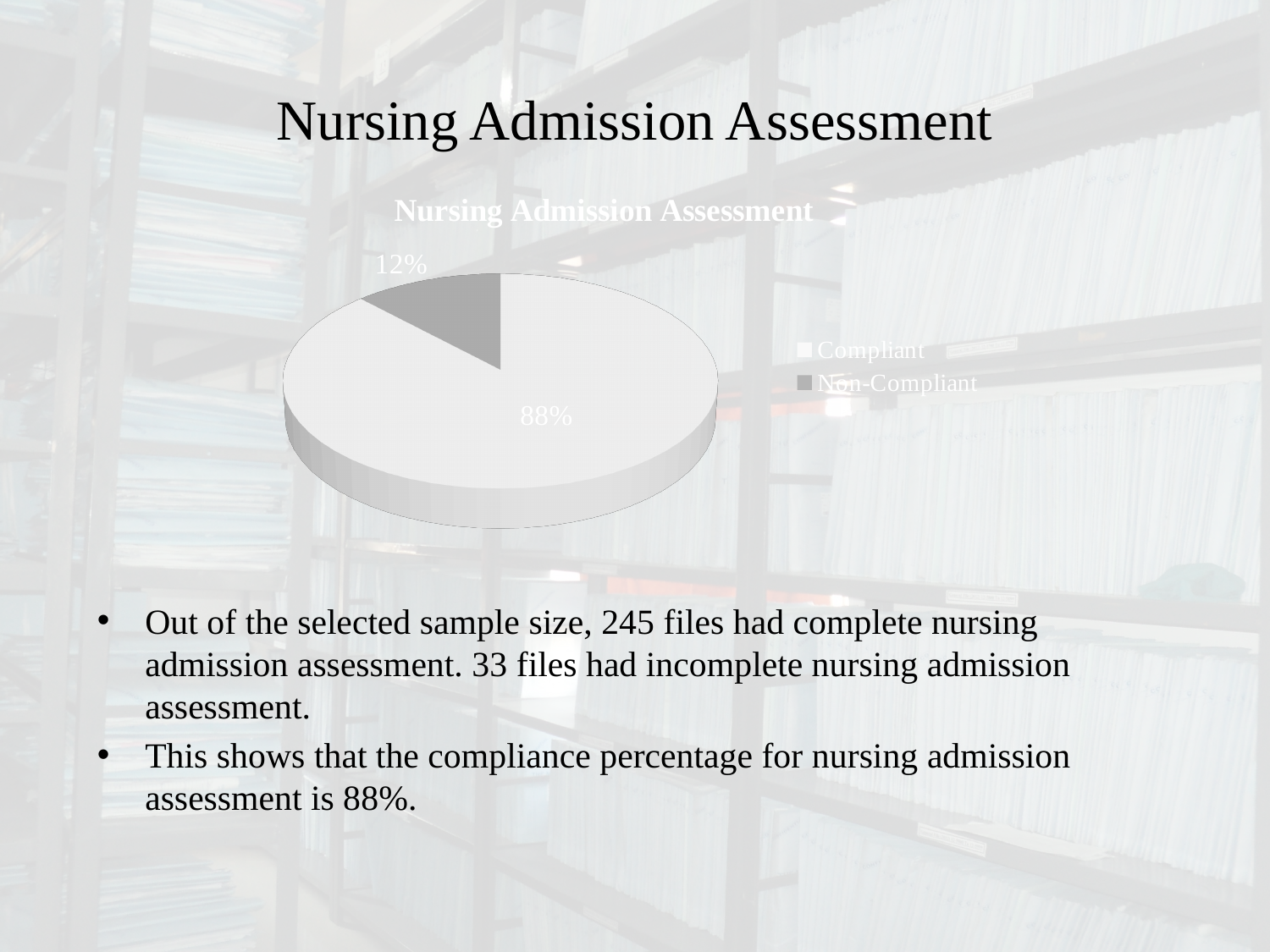
How many slices does the pie chart have? 2 Which slice of the pie is the largest? Compliant What percentage of the pie is labelled Non-Compliant? 12% What is the difference in percentage points between the Compliant and Non-Compliant slices? 76 Which is larger, the Compliant slice or the Non-Compliant slice? Compliant Which slice of the pie is the smallest? Non-Compliant What percentage of the pie is labelled Compliant? 88% What kind of chart is shown on the slide? Pie chart What is the title of the chart? Nursing Admission Assessment How many entries does the legend list? 2 What share of the pie does the Non-Compliant slice represent? 12%